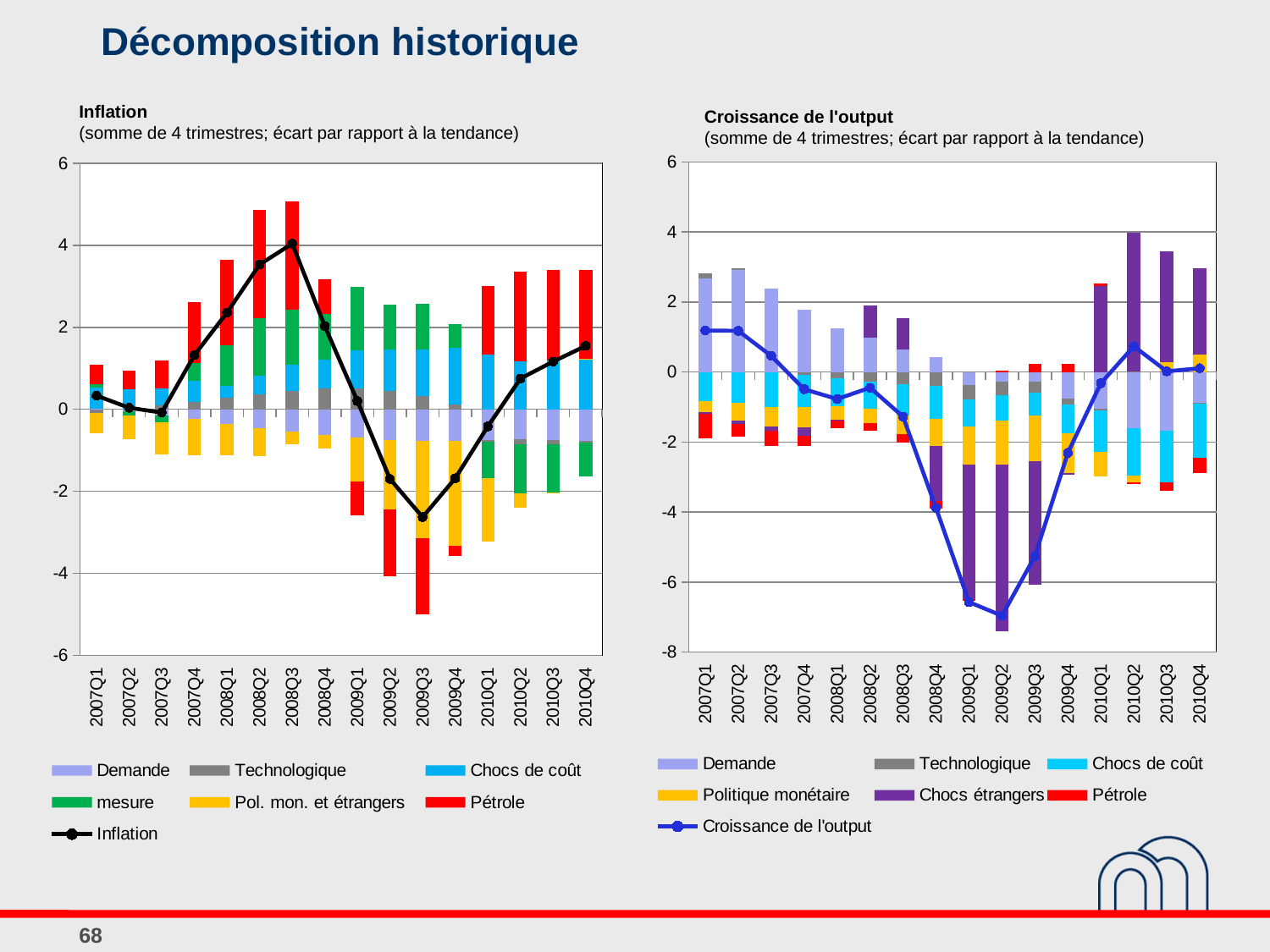
What kind of chart is the Inflation chart? stacked bar chart with a line On the Inflation chart, in which quarter does the Inflation line reach its lowest value? 2009Q3 On the Croissance de l'output chart, in which quarter does the Croissance de l'output line reach its lowest value? 2009Q2 On the Inflation chart, does the Inflation line rise or fall from 2008Q3 to 2009Q3? fall On the Croissance de l'output chart, is the value of the Croissance de l'output line for 2010Q2 greater or less than 0? greater On the Croissance de l'output chart, how many entries does the legend list? 7 On the Inflation chart, how many quarters are shown on the x axis? 16 On the Inflation chart, is the value of the Inflation line for 2009Q3 greater or less than -2? less On the Inflation chart, is the value of the Inflation line for 2008Q3 greater or less than 2? greater On the Inflation chart, in which quarter does the Inflation line reach its highest value? 2008Q3 On the Croissance de l'output chart, which colour represents Chocs étrangers in the legend? purple